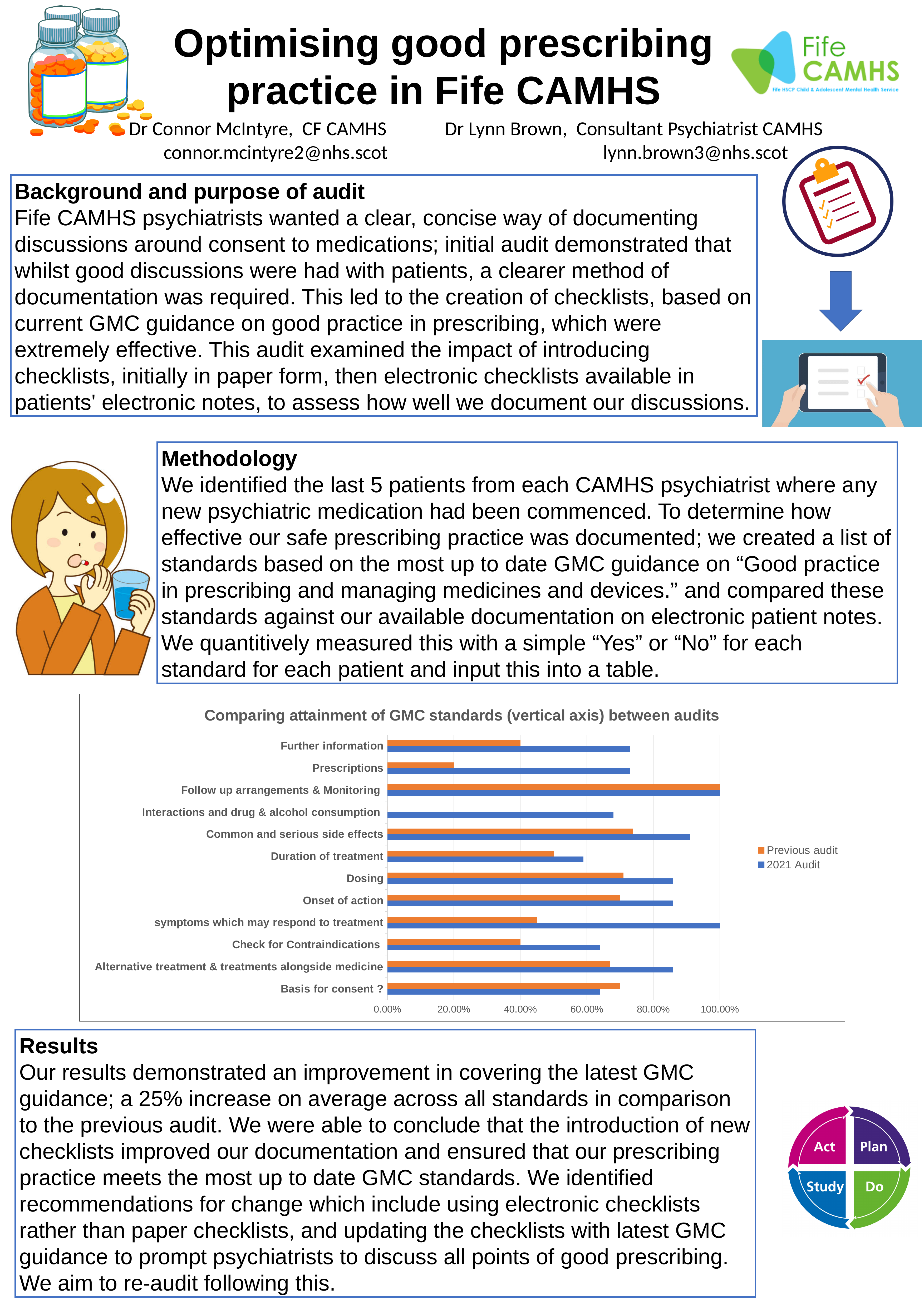
What is the 2021 Audit value for Follow up arrangements & Monitoring? 100.00% What is the title of the chart? Comparing attainment of GMC standards (vertical axis) between audits Which category has the highest Previous audit value? Follow up arrangements & Monitoring Is the 2021 Audit value for Duration of treatment greater or less than 80.00%? less What is the 2021 Audit value for symptoms which may respond to treatment? 100.00% What kind of chart is shown on the slide? Bar chart How many GMC standard categories are plotted on the vertical axis of the chart? 12 How many series does the chart legend list? 2 Is the 2021 Audit value for Common and serious side effects greater or less than 80.00%? greater Is the 2021 Audit value for Prescriptions greater or less than 60.00%? greater For Prescriptions, which series has the larger value, Previous audit or 2021 Audit? 2021 Audit For Basis for consent ?, which series has the larger value, Previous audit or 2021 Audit? Previous audit